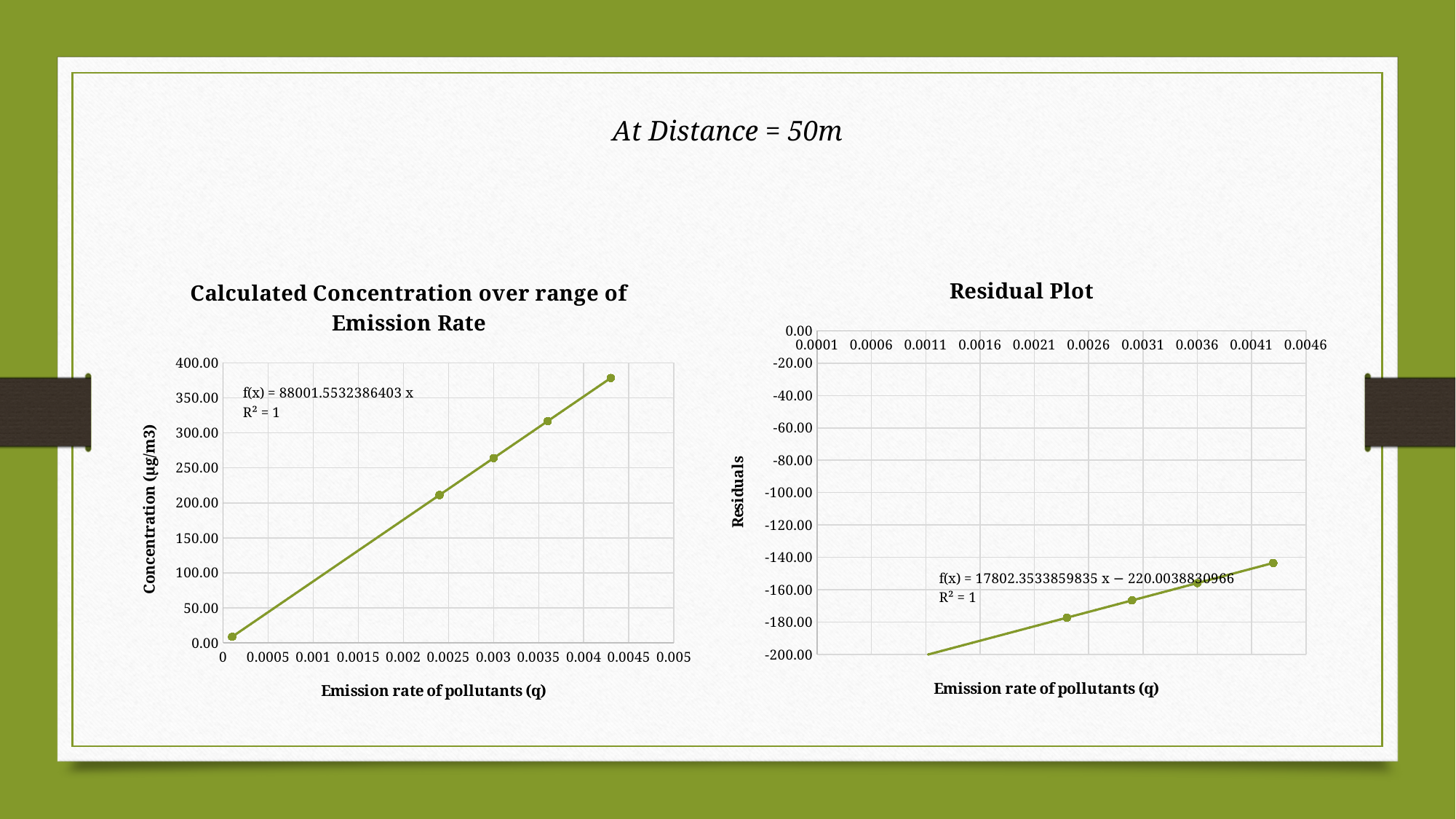
On the 'Residual Plot' chart, do the residual values rise or fall as emission rate increases? rise On the 'Calculated Concentration over range of Emission Rate' chart, is the value of the highest point greater or less than 350.00? greater How many data points are plotted on the 'Residual Plot' chart? 4 On the 'Residual Plot' chart, is the value of the highest point greater or less than -160.00? greater On the 'Calculated Concentration over range of Emission Rate' chart, is the value of the lowest point greater or less than 50.00? less On the 'Calculated Concentration over range of Emission Rate' chart, which point has the larger value: the leftmost point or the rightmost point? the rightmost point How many data points are plotted on the 'Calculated Concentration over range of Emission Rate' chart? 5 What is the y-axis title of the 'Residual Plot' chart? Residuals What R² value is shown on the 'Calculated Concentration over range of Emission Rate' chart? R² = 1 What kind of chart is the 'Calculated Concentration over range of Emission Rate' chart? scatter chart On the 'Calculated Concentration over range of Emission Rate' chart, does concentration rise or fall as emission rate increases? rise